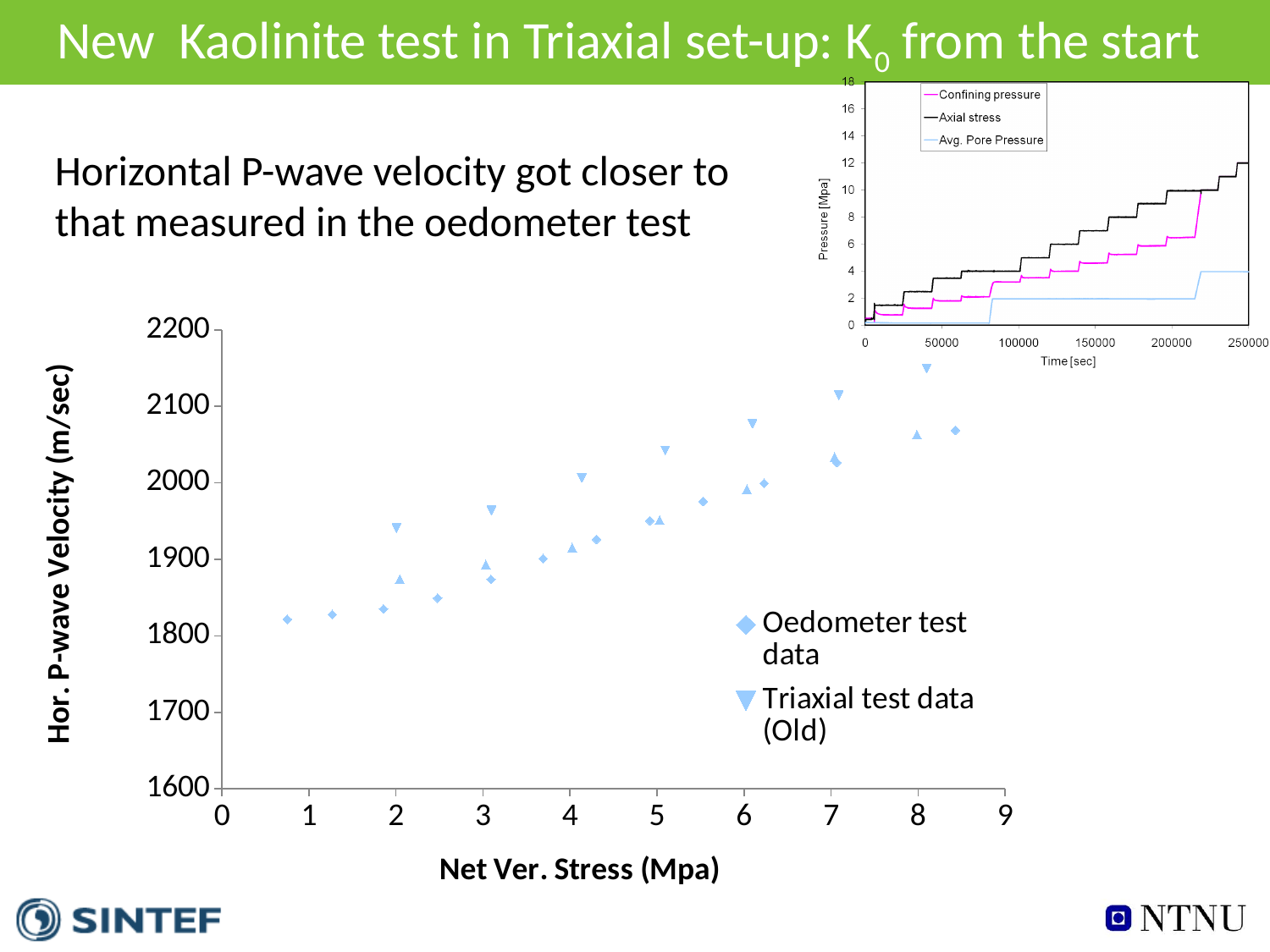
On the large chart, is the lowest Oedometer test data value (at a Net Ver. Stress below 1) greater or less than 1900? less On the small inset chart in the top right, is the Avg. Pore Pressure value at 250000 sec greater or less than 6? less On the large chart, at a Net Ver. Stress of about 2, which is larger: the Triaxial test data (Old) value or the Oedometer test data value? Triaxial test data (Old) On the large chart, what is the label of the x axis? Net Ver. Stress (Mpa) On the large chart, what kind of chart is it? scatter chart On the large chart, is the Triaxial test data (Old) value at a Net Ver. Stress of about 8 greater or less than 2100? greater On the large chart, what is the label of the y axis? Hor. P-wave Velocity (m/sec) On the small inset chart in the top right, which series has the highest value at the end of the time axis? Axial stress On the large chart, do the Oedometer test data values rise or fall as Net Ver. Stress increases? rise On the small inset chart in the top right, what kind of chart is it? line chart On the small inset chart in the top right, how many series does the legend list? 3 On the large chart, how many series does the legend list? 2